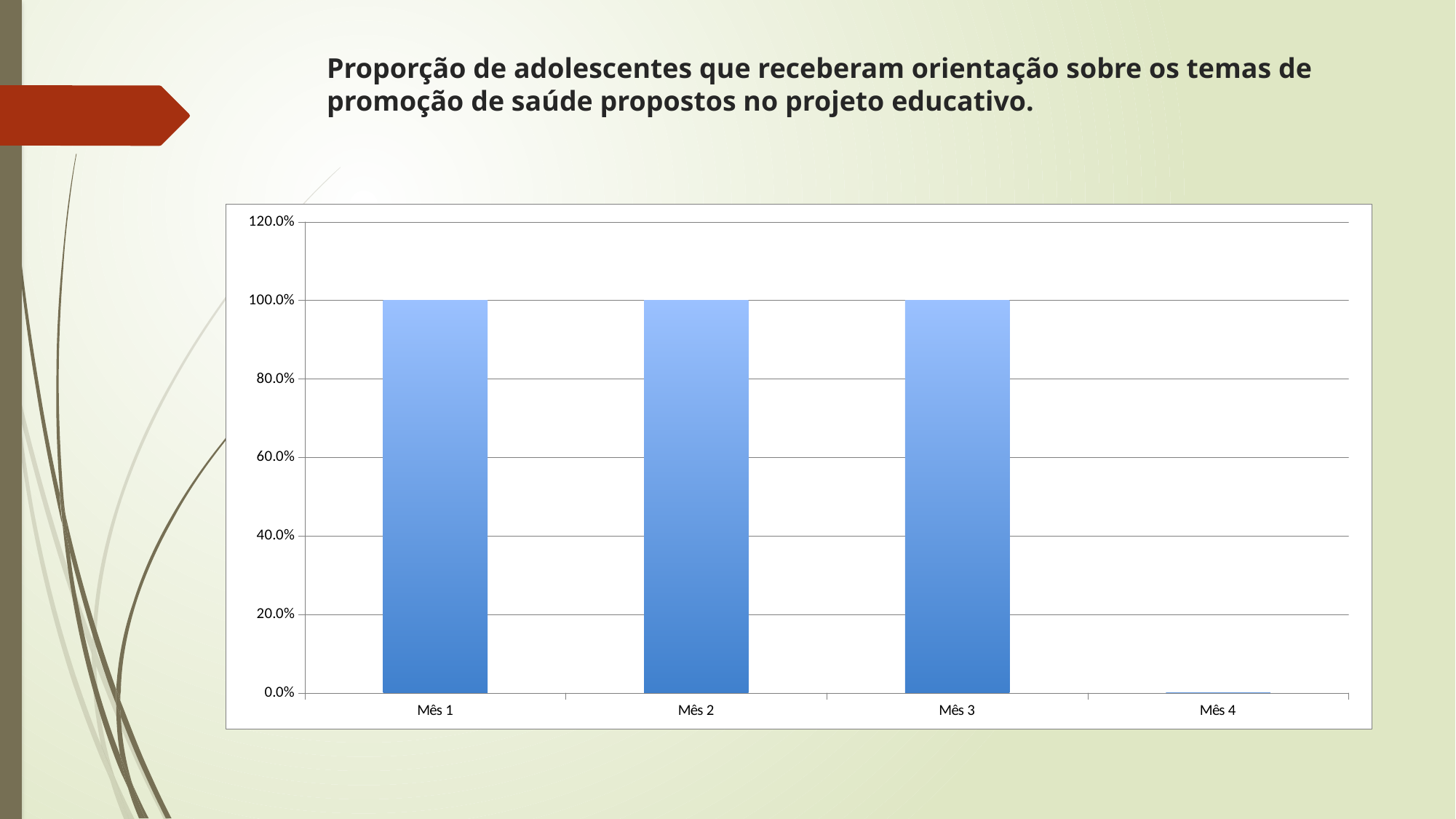
What is the value for Mês 1? 100.0% How many categories are shown on the x axis of the chart? 4 What is the value for Mês 3? 100.0% What is the label of the first category on the x axis? Mês 1 What is the value for Mês 4? 0.0% What type of chart is shown on the slide? bar chart What is the highest tick label shown on the y axis? 120.0% Which category has the lowest value? Mês 4 Which is larger, the value for Mês 3 or the value for Mês 4? Mês 3 What is the value for Mês 2? 100.0% What is the difference between the value for Mês 1 and the value for Mês 4? 100.0% Is the value for Mês 2 greater or less than 80.0%? greater